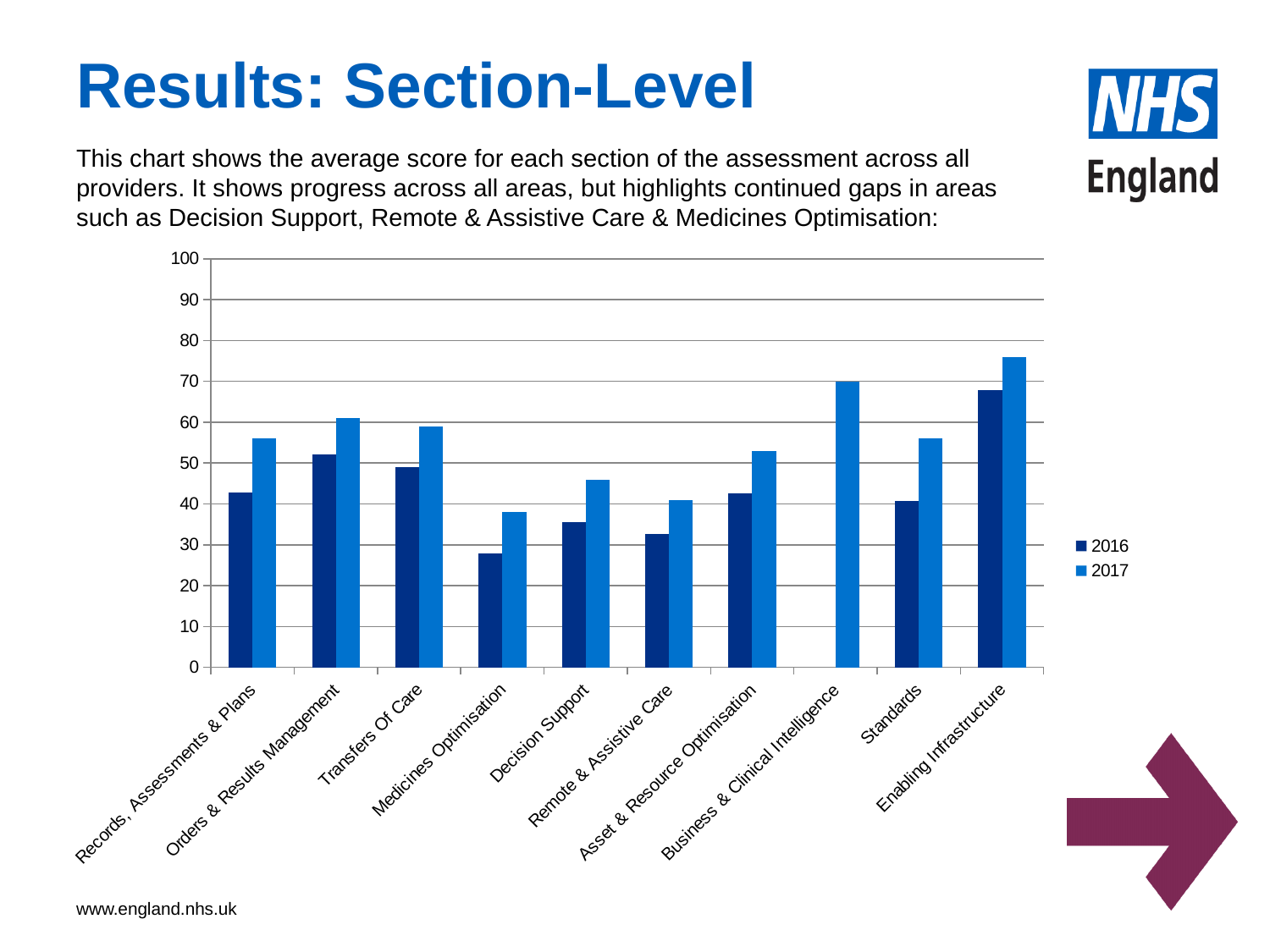
Which section has the lowest 2016 score? Medicines Optimisation What kind of chart is shown on the slide? bar chart Which is larger: the 2017 value for Business & Clinical Intelligence or the 2017 value for Standards? Business & Clinical Intelligence Which section has the lowest 2017 score? Medicines Optimisation How many sections (categories) are shown on the x axis of the chart? 10 How many series does the chart's legend list? 2 Is the 2017 value for Records, Assessments & Plans greater or less than 50? greater Which section has the highest 2017 score? Enabling Infrastructure Is the 2017 value for Enabling Infrastructure greater or less than 70? greater Is the 2017 value for Decision Support greater or less than 50? less Which section has no 2016 bar shown in the chart? Business & Clinical Intelligence